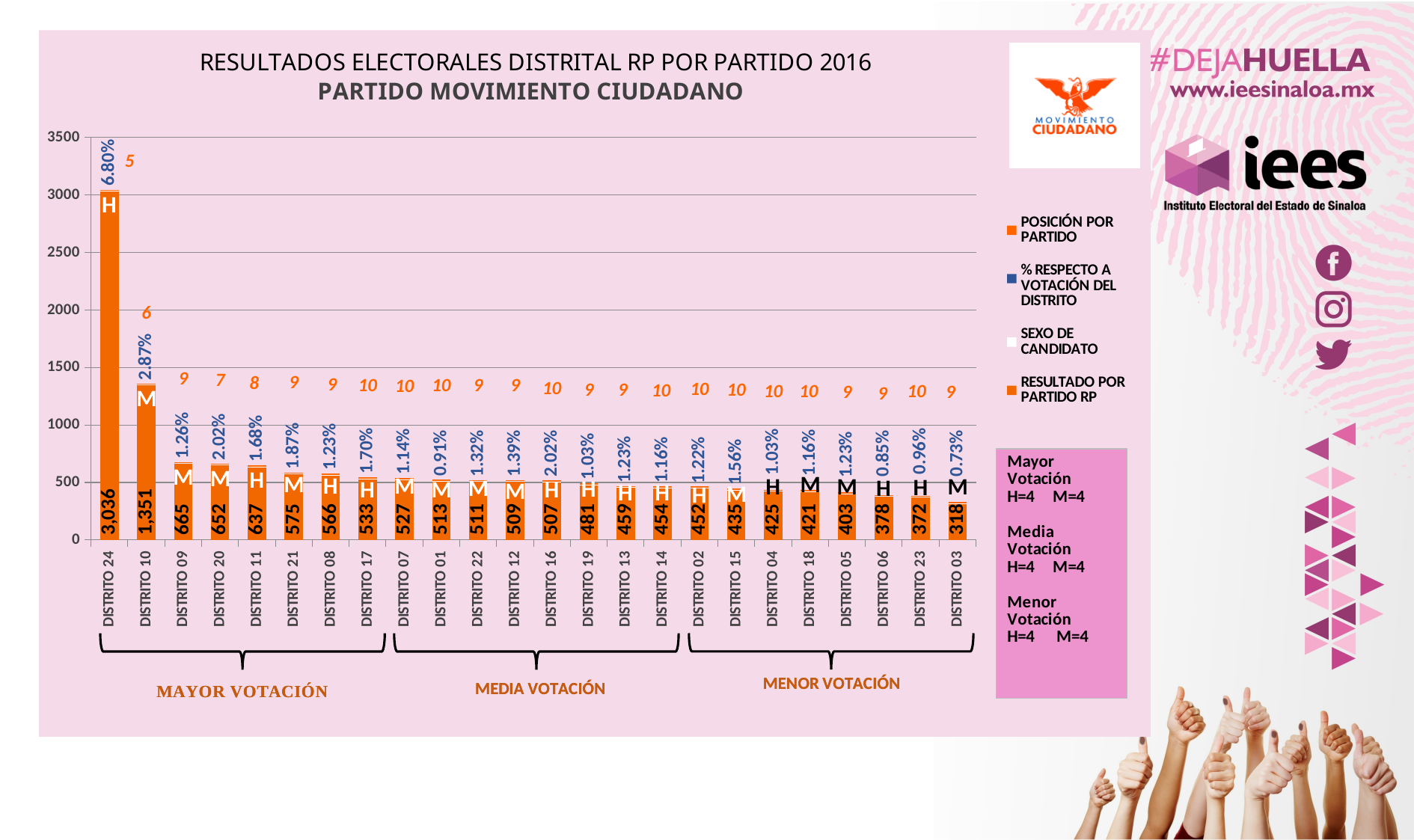
What is the difference between the vote results of DISTRITO 24 and DISTRITO 10? 1,685 Is the vote result for DISTRITO 10 greater or less than 1000? greater How many districts are plotted on the chart? 24 What is the vote result shown for DISTRITO 16? 507 Which district has the highest vote result? DISTRITO 24 How many entries does the legend list? 4 Which has a larger vote result, DISTRITO 09 or DISTRITO 15? DISTRITO 09 What is the vote result (RESULTADO POR PARTIDO RP) for DISTRITO 24? 3,036 Do the vote results rise or fall from left to right along the x axis? Fall What kind of chart is shown on the slide? Bar chart Which district has the lowest vote result? DISTRITO 03 What percentage (% RESPECTO A VOTACIÓN DEL DISTRITO) is shown for DISTRITO 10? 2.87%